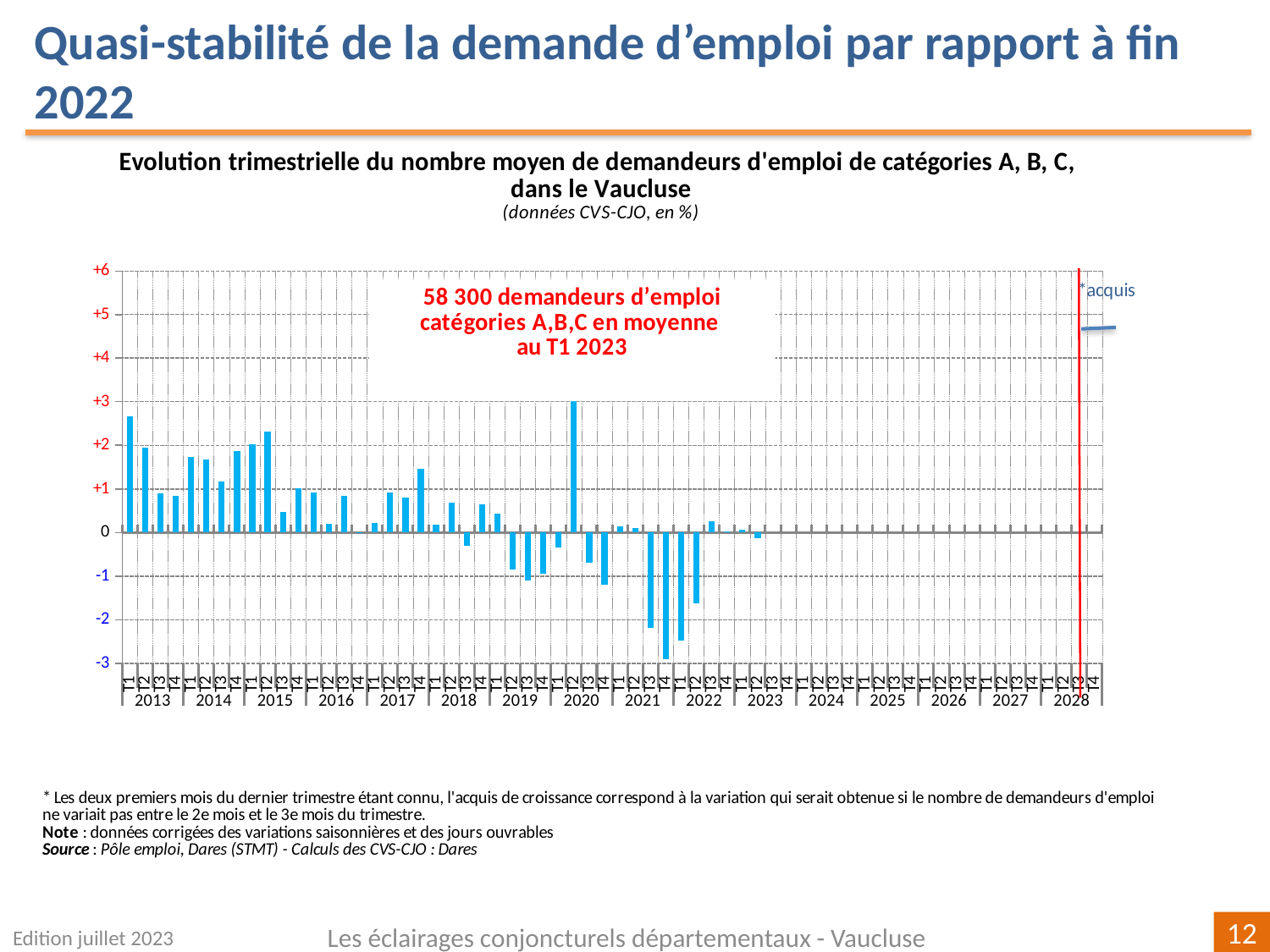
Which quarter has the highest value on the chart? T2 2020 What kind of chart is shown on the slide? bar chart Is the value for T1 2013 greater or less than +2? greater Is the value for T1 2022 greater or less than -2? less How many year labels appear along the x axis of the chart? 16 Is the value for T2 2020 greater or less than +2? greater Which is larger, the value for T2 2020 or the value for T1 2013? T2 2020 According to the red annotation on the chart, how many job seekers in categories A, B, C were there on average in T1 2023? 58 300 Which quarter has the lowest value on the chart? T4 2021 Which is lower, the value for T3 2021 or the value for T4 2021? T4 2021